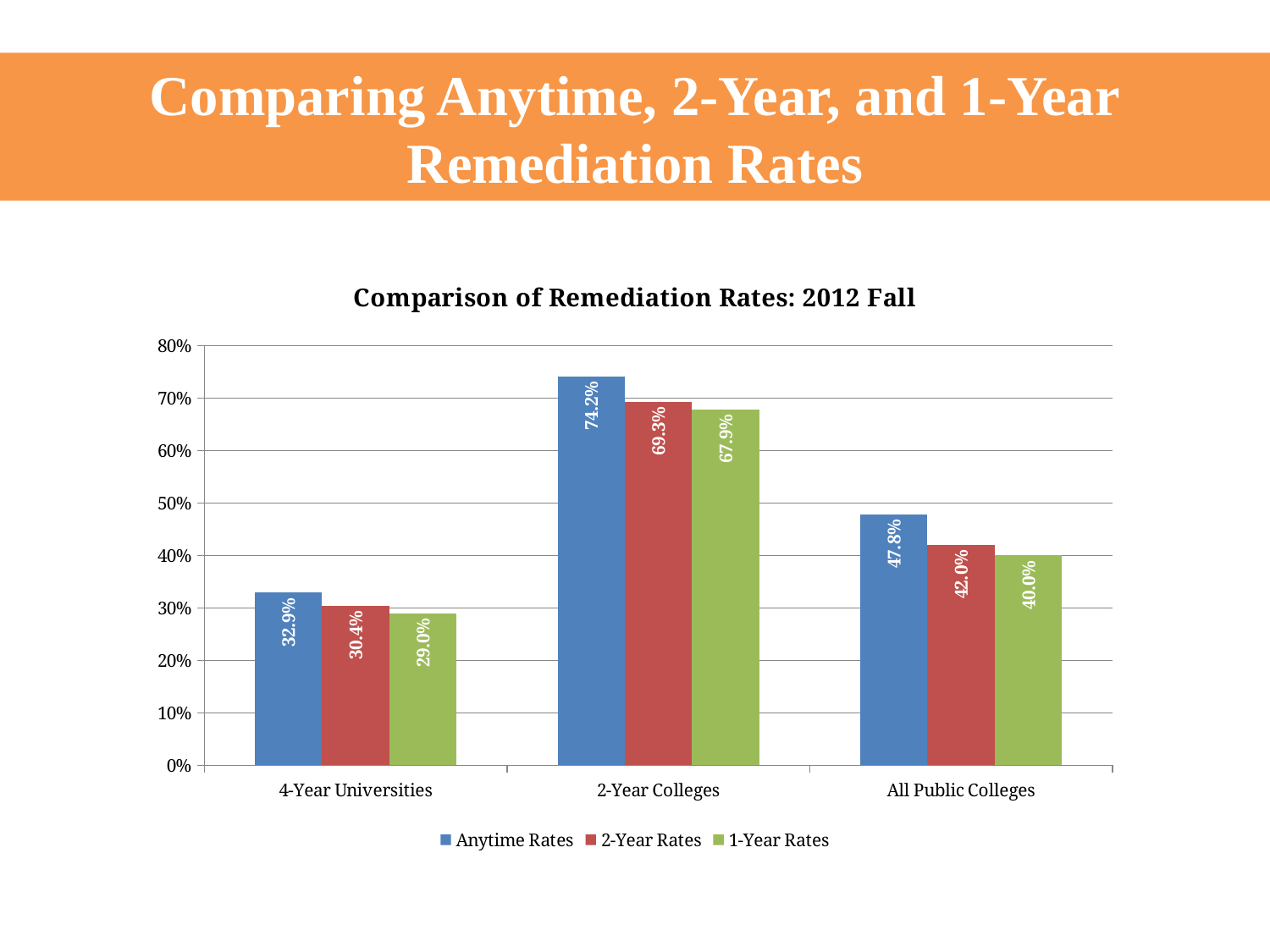
What is the title of the chart? Comparison of Remediation Rates: 2012 Fall What kind of chart is shown on the slide? bar chart What is the 1-Year Rates value for 4-Year Universities? 29.0% Which category has the highest Anytime Rates value? 2-Year Colleges What is the Anytime Rates value for 2-Year Colleges? 74.2% Which category has the lowest 1-Year Rates value? 4-Year Universities Which is larger: the 2-Year Rates value for 4-Year Universities or the 1-Year Rates value for All Public Colleges? 1-Year Rates value for All Public Colleges What is the difference between the Anytime Rates and 1-Year Rates values for All Public Colleges? 7.8% What is the 2-Year Rates value for All Public Colleges? 42.0% Is the Anytime Rates value for 4-Year Universities greater or less than 40%? less How many series does the legend list? 3 How many categories are shown on the x axis? 3